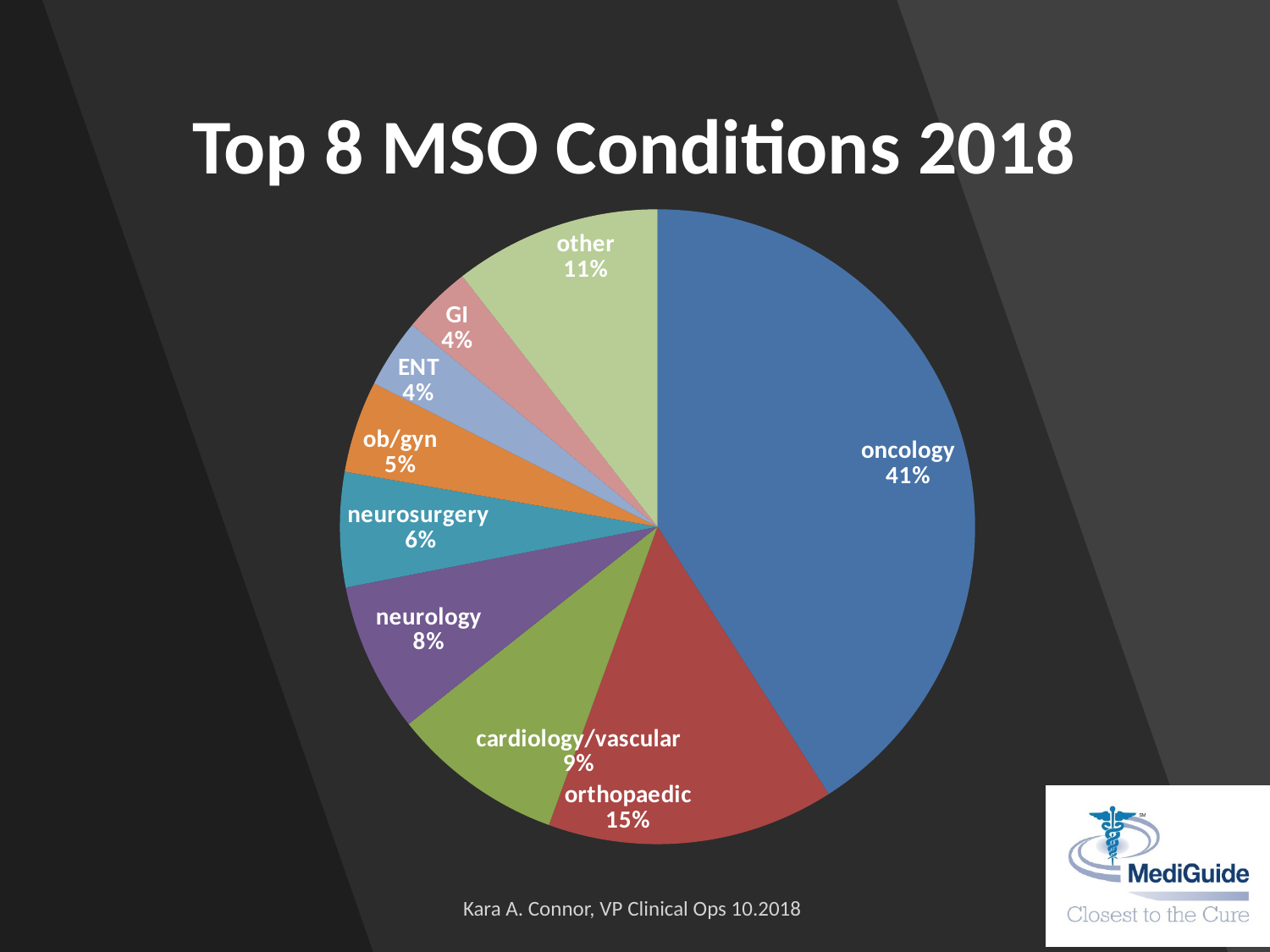
What is the value shown for orthopaedic? 15% What is the difference between the oncology and orthopaedic shares? 26% How many slices does the pie chart have? 9 Which category has the largest slice of the pie? oncology Which is larger, cardiology/vascular or neurology? cardiology/vascular What share is shown for the 'other' slice? 11% What kind of chart is shown on the slide? pie chart What percentage is shown for neurosurgery? 6% What share of the pie does oncology represent? 41% What is the title of the chart? Top 8 MSO Conditions 2018 Which category has the smallest share, GI or neurology? GI What is the combined share of ENT and GI? 8%